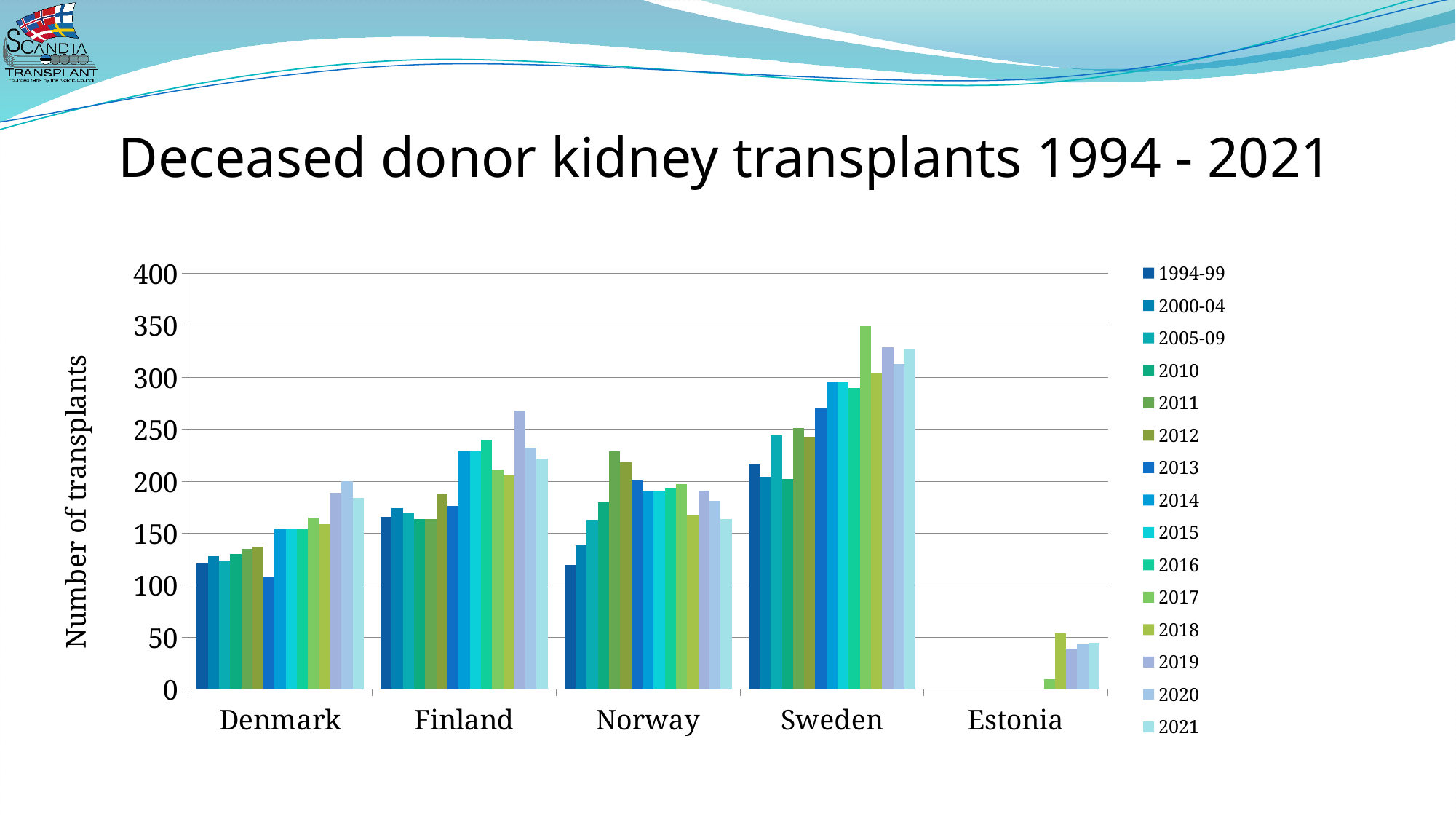
What type of chart is shown on the slide? Bar chart Which country has the lowest number of deceased donor kidney transplants in the chart? Estonia Is the value for Finland in 2019 greater or less than 250? greater Is the value for Sweden in 2017 greater or less than 300? greater Is the value for Denmark in 2013 greater or less than 150? less What is the label of the y axis? Number of transplants What is the title of the chart on the slide? Deceased donor kidney transplants 1994 - 2021 Which is larger, the value for Finland in 2019 or the value for Norway in 2019? Finland in 2019 How many countries are shown on the x axis of the chart? 5 Which country has the highest number of deceased donor kidney transplants in the chart? Sweden How many series does the legend list? 15